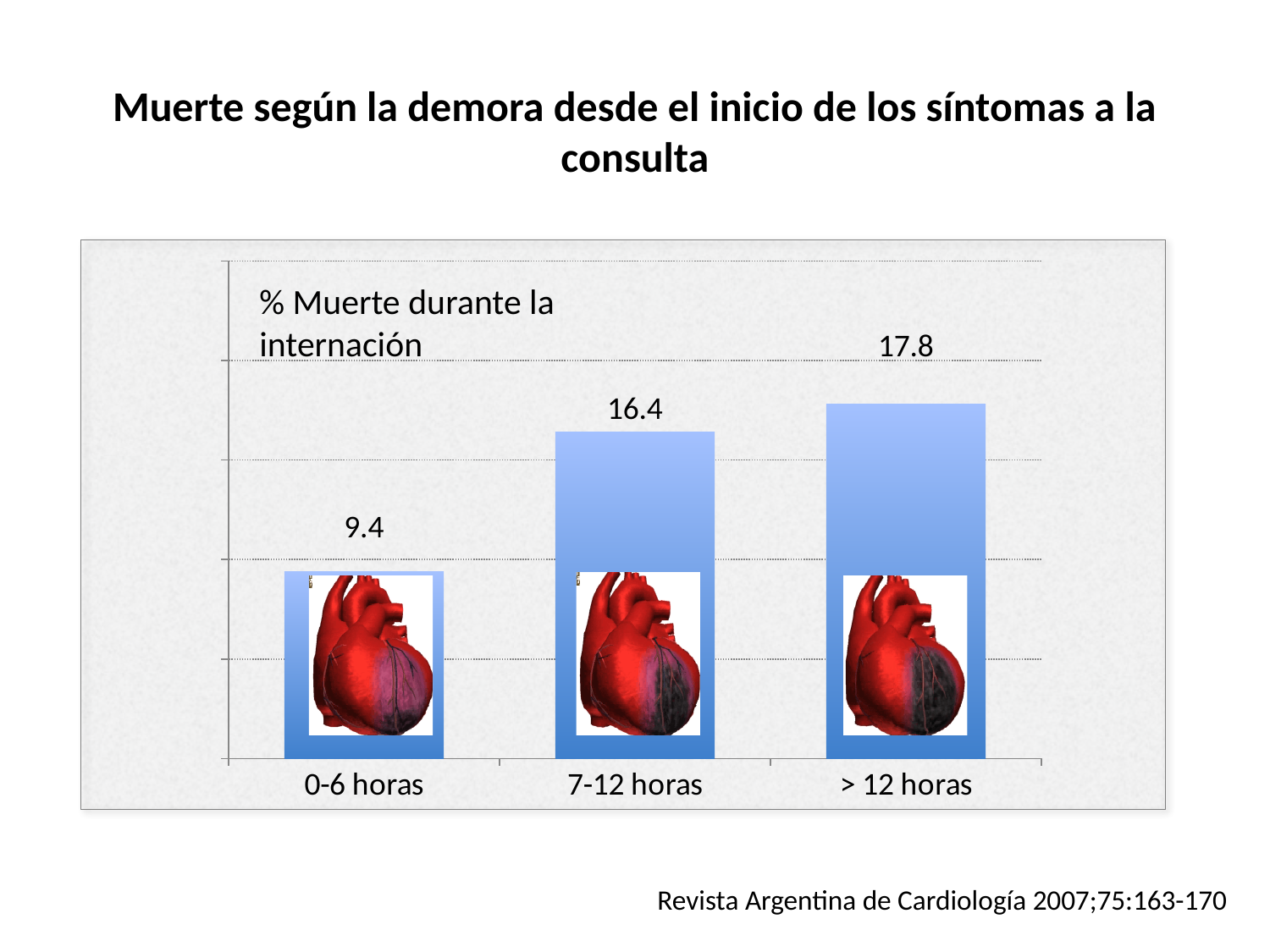
What is the difference between the values for > 12 horas and 0-6 horas? 8.4 Which category has the lowest value? 0-6 horas Which category has the highest value? > 12 horas How many categories are shown on the x axis? 3 What is the value for 0-6 horas? 9.4 What is the value for 7-12 horas? 16.4 What kind of chart is shown? bar chart What is the difference between the values for 7-12 horas and 0-6 horas? 7 What label is shown inside the plot area describing the plotted measure? % Muerte durante la internación Which is larger, the value for 7-12 horas or the value for 0-6 horas? 7-12 horas Do the values rise or fall from left to right along the x axis? rise What is the value for > 12 horas? 17.8